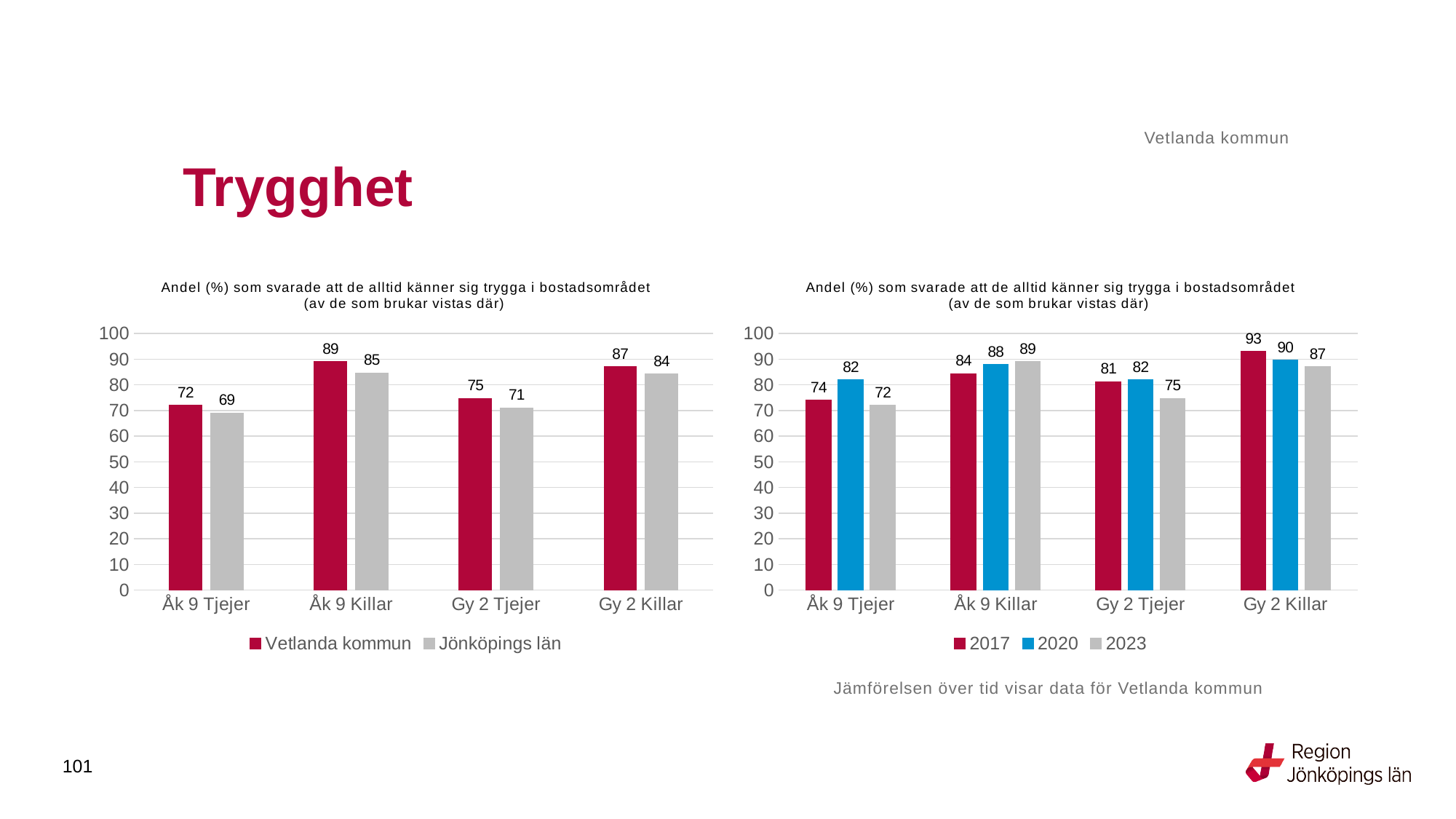
What kind of chart is the right chart? bar chart In the right chart, is the 2017 value for Gy 2 Killar larger or smaller than the 2023 value for Gy 2 Killar? larger In the left chart, what is the value for Vetlanda kommun for Åk 9 Killar? 89 In the right chart, what is the value for 2020 for Åk 9 Tjejer? 82 In the right chart, what is the value for 2023 for Gy 2 Killar? 87 In the right chart, which category has the highest value for 2017? Gy 2 Killar In the left chart, how many series does the legend list? 2 In the right chart, what is the difference between the 2020 and 2023 values for Gy 2 Tjejer? 7 In the right chart, how many categories are shown on the x axis? 4 In the left chart, what is the difference between Vetlanda kommun and Jönköpings län for Gy 2 Tjejer? 4 In the left chart, what is the value for Jönköpings län for Gy 2 Tjejer? 71 In the left chart, which category has the lowest value for Jönköpings län? Åk 9 Tjejer